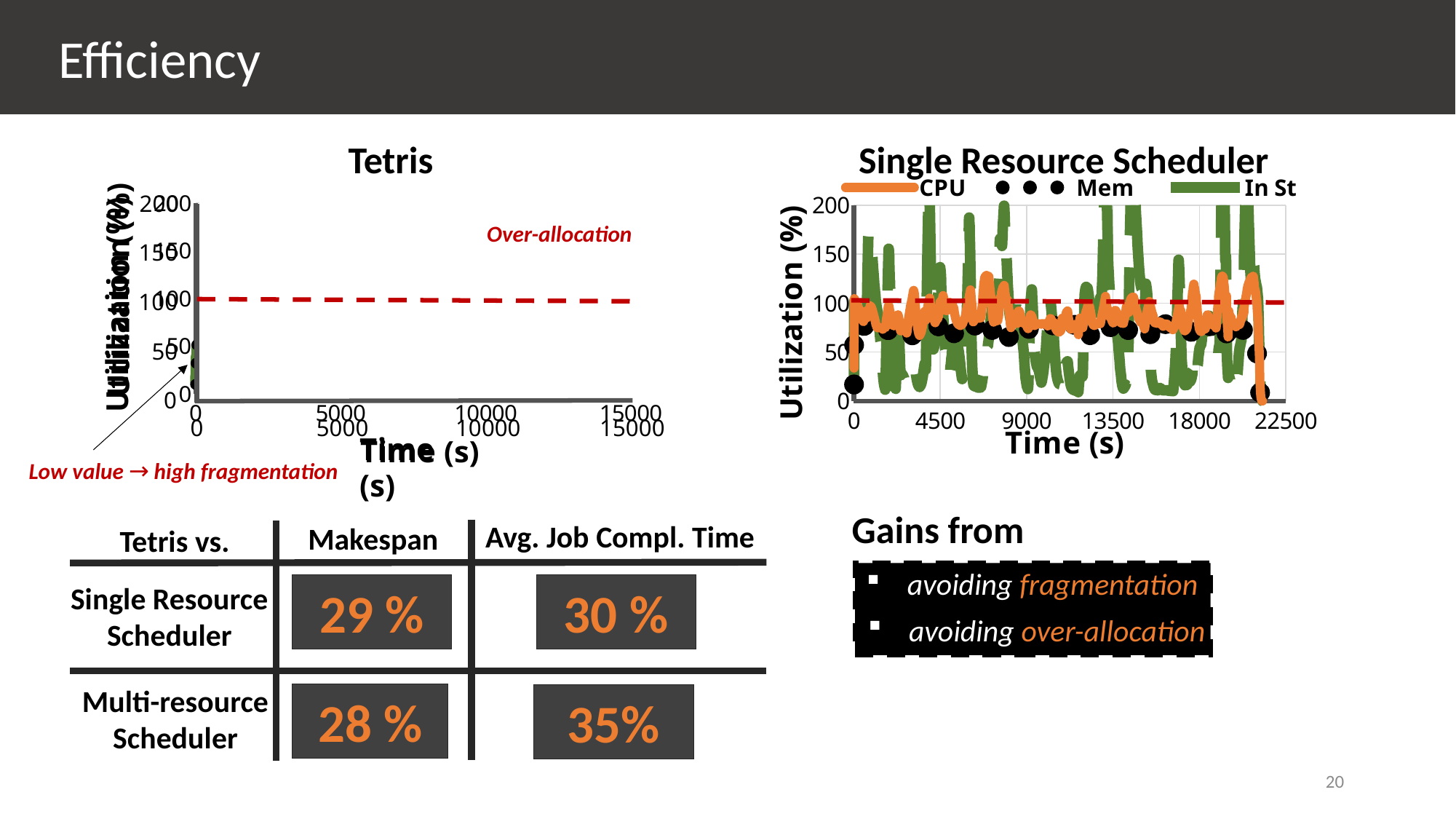
What is the title of the chart on the left of the slide? Tetris In the Single Resource Scheduler chart, what is the label of the y axis? Utilization (%) In the Tetris chart, what label is given to the dashed red horizontal line? Over-allocation In the Single Resource Scheduler chart, how many series does the legend list? 3 In the Single Resource Scheduler chart, what is the largest value shown on the x axis? 22500 What is the title of the chart on the right of the slide? Single Resource Scheduler In the Single Resource Scheduler chart, is the peak value of the CPU series greater or less than 150? less In the Tetris chart, what is the largest value shown on the x axis? 15000 In the Single Resource Scheduler chart, what are the series named in the legend? CPU, Mem, In St In the Single Resource Scheduler chart, is the peak value of the In St series greater or less than 150? greater In the Single Resource Scheduler chart, at what utilization level is the dashed red horizontal line drawn? 100 What kind of chart is the Single Resource Scheduler chart? line chart